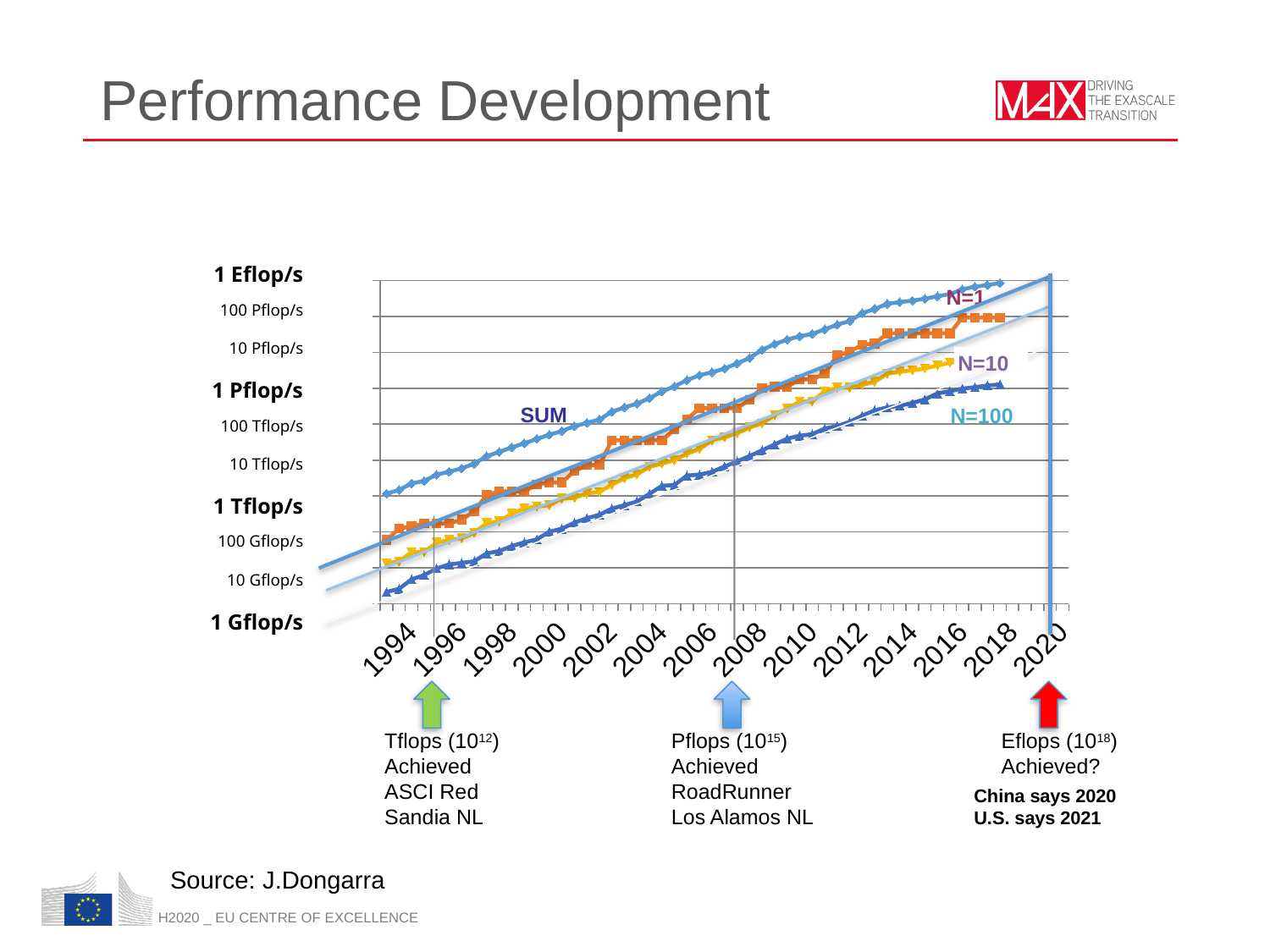
Which series has the highest values across the chart? SUM Do the plotted values rise or fall from 1994 to 2018? rise What kind of chart is shown on the slide? line chart Which series is higher, N=1 or N=10? N=1 Which series has the lowest values across the chart? N=100 What is the last year shown on the x axis? 2020 How many series are plotted on the chart? 4 What is the label at the top of the y axis? 1 Eflop/s Is the value of the SUM series in 2018 greater or less than 100 Pflop/s? greater Is the value of the N=100 series in 1994 greater or less than 10 Gflop/s? less Is the value of the N=10 series in 1994 greater or less than 10 Gflop/s? greater What is the title of the slide containing the chart? Performance Development